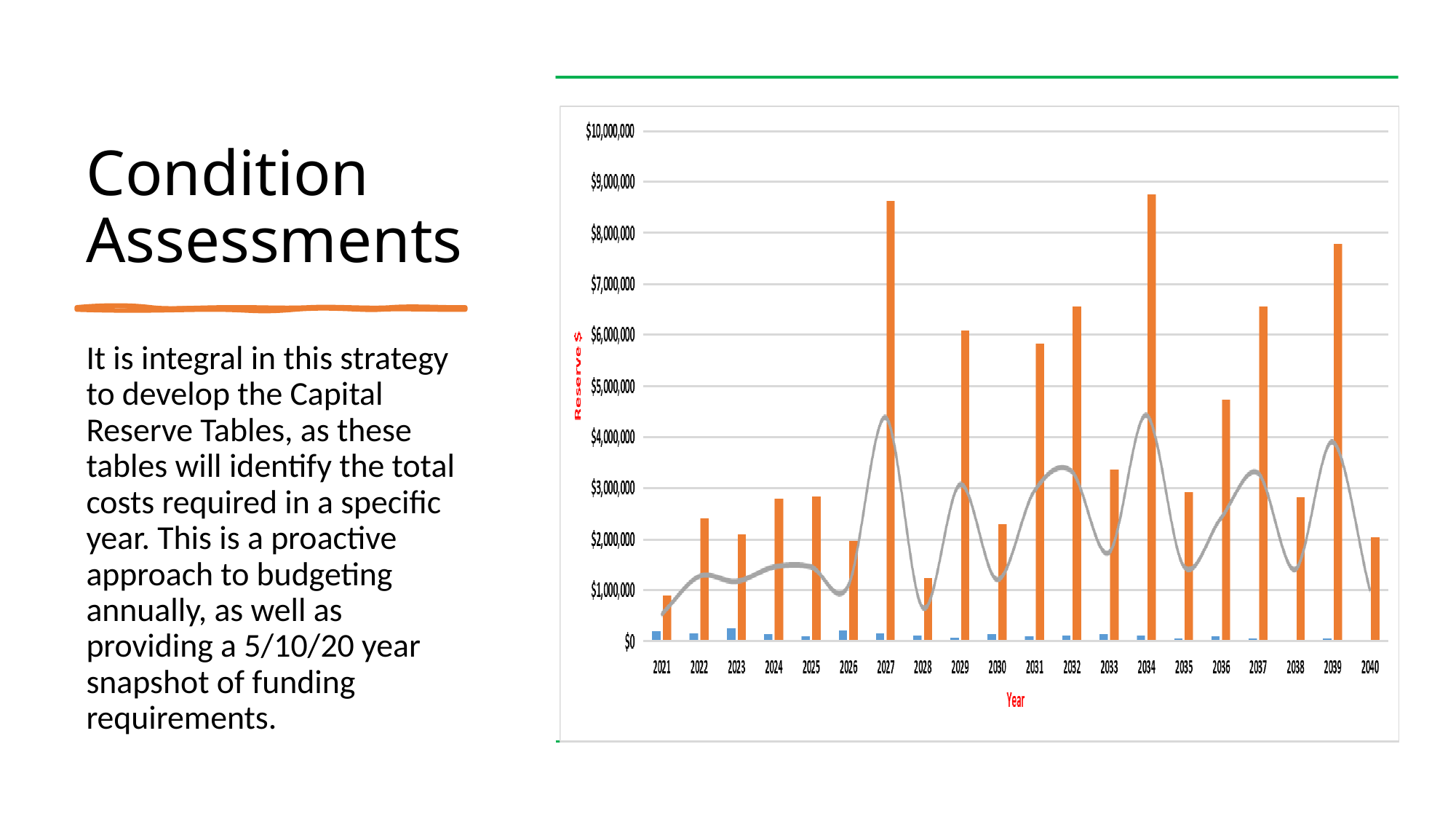
What kind of chart is shown on the slide? Bar and line chart Is the orange bar value for 2027 greater or less than $8,000,000? greater Is the orange bar value for 2032 greater or less than $6,000,000? greater Is the orange bar value for 2021 greater or less than $1,000,000? less Which year has the lowest orange bar in the chart? 2021 How many years are shown along the x axis of the chart? 20 What is the label on the horizontal axis of the chart? Year Which year has the larger orange bar, 2039 or 2040? 2039 What is the label on the vertical axis of the chart? Reserve $ Which year has the larger orange bar, 2027 or 2028? 2027